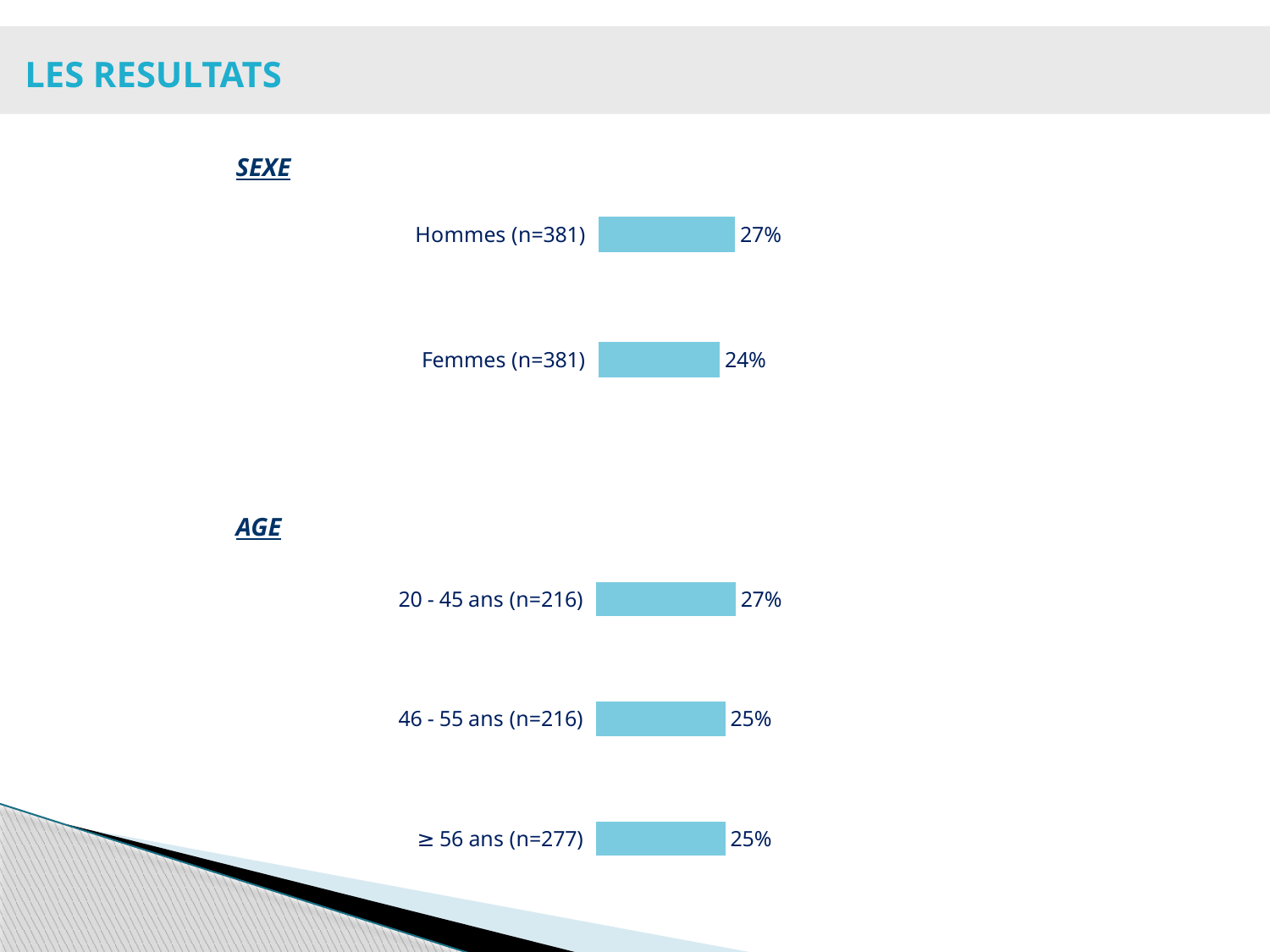
In the AGE chart, how many age groups are plotted? 3 In the SEXE chart, what is the value for Femmes (n=381)? 24% In the AGE chart, which age group has the highest value? 20 - 45 ans (n=216) What kind of chart is the SEXE chart? Bar chart In the SEXE chart, which category has the higher value? Hommes (n=381) In the AGE chart, what is the value for 46 - 55 ans (n=216)? 25% In the AGE chart, what is the difference between the values for 20 - 45 ans and 46 - 55 ans? 2% In the SEXE chart, how many categories are plotted? 2 In the AGE chart, what is the value for 20 - 45 ans (n=216)? 27% In the AGE chart, what is the value for ≥ 56 ans (n=277)? 25% In the SEXE chart, what is the value for Hommes (n=381)? 27% In the SEXE chart, what is the difference between the values for Hommes and Femmes? 3%